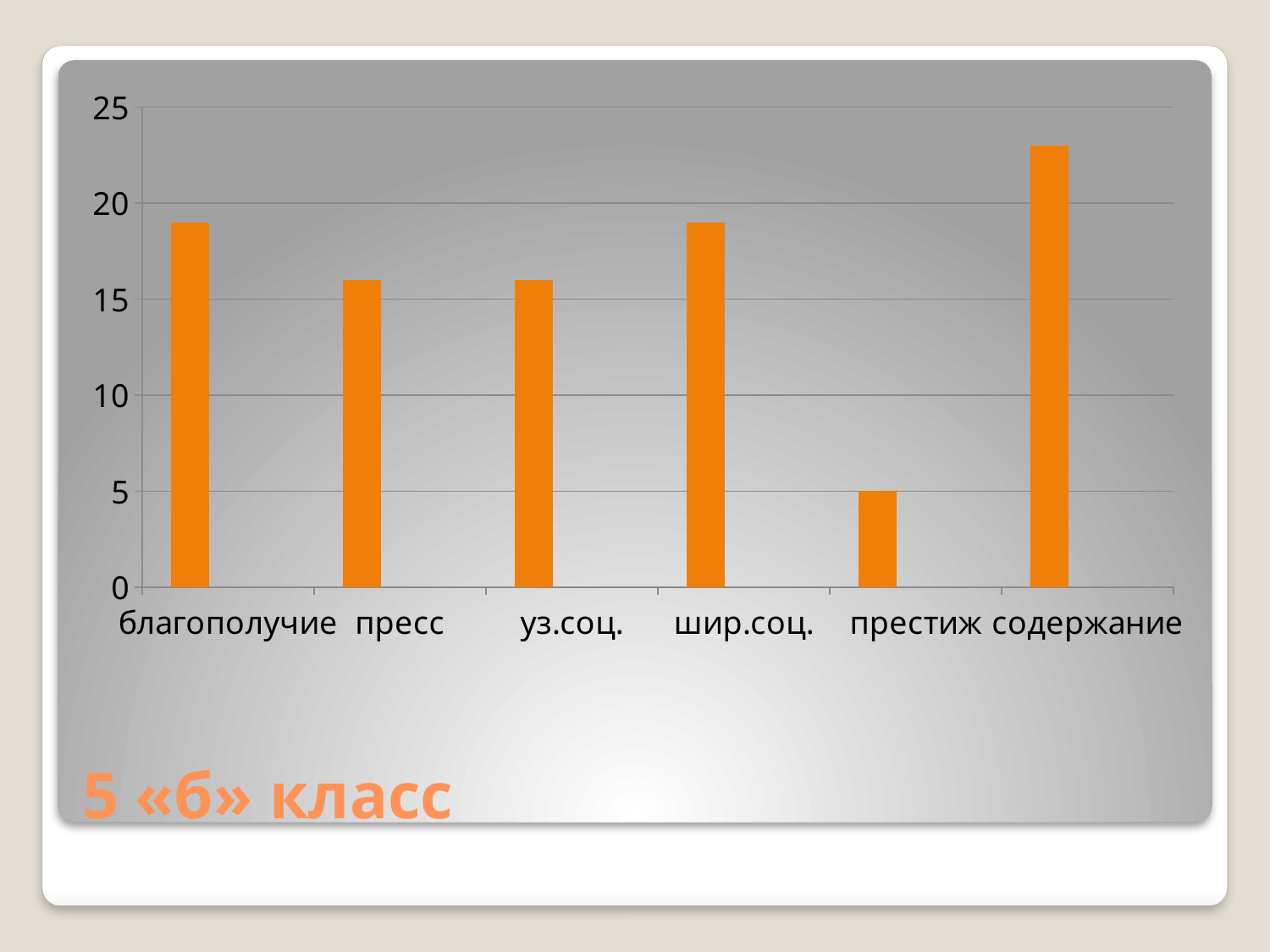
Which category has the lowest bar in the chart? престиж Is the value for благополучие greater or less than 20? less How many categories are shown on the x axis of the chart? 6 What kind of chart is shown on the slide? bar chart What is the title text shown on the slide below the chart? 5 «б» класс Is the value for содержание greater or less than 20? greater Which is larger, the value for благополучие or the value for пресс? благополучие Which category has the highest bar in the chart? содержание What is the value for престиж in the chart? 5 Is the value for уз.соц. greater or less than 20? less Which is larger, the value for шир.соц. or the value for престиж? шир.соц.